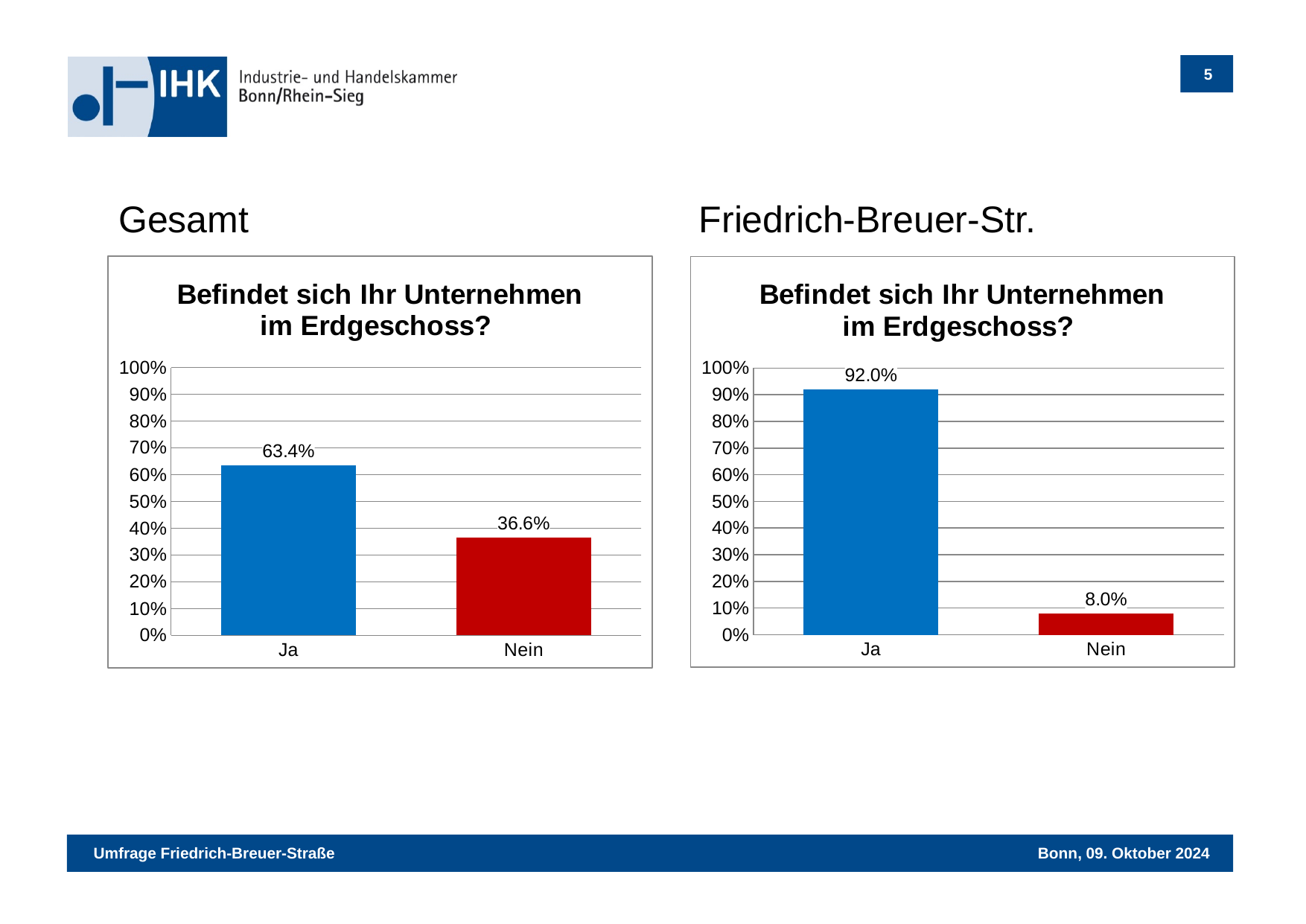
In the right chart (Friedrich-Breuer-Str.), what is the difference between the values for Ja and Nein? 84.0% In the left chart (Gesamt), what is the value for Ja? 63.4% Which chart has the larger value for Ja, the left chart (Gesamt) or the right chart (Friedrich-Breuer-Str.)? Friedrich-Breuer-Str. How many categories are shown in the left chart (Gesamt)? 2 In the right chart (Friedrich-Breuer-Str.), what is the value for Nein? 8.0% In the left chart (Gesamt), what is the value for Nein? 36.6% In the right chart (Friedrich-Breuer-Str.), what is the value for Ja? 92.0% In the left chart (Gesamt), what is the difference between the values for Ja and Nein? 26.8% What kind of chart is the right chart (Friedrich-Breuer-Str.)? bar chart In the right chart (Friedrich-Breuer-Str.), which category has the lowest value? Nein In the left chart (Gesamt), which category has the highest value? Ja What is the title of the left chart (Gesamt)? Befindet sich Ihr Unternehmen im Erdgeschoss?